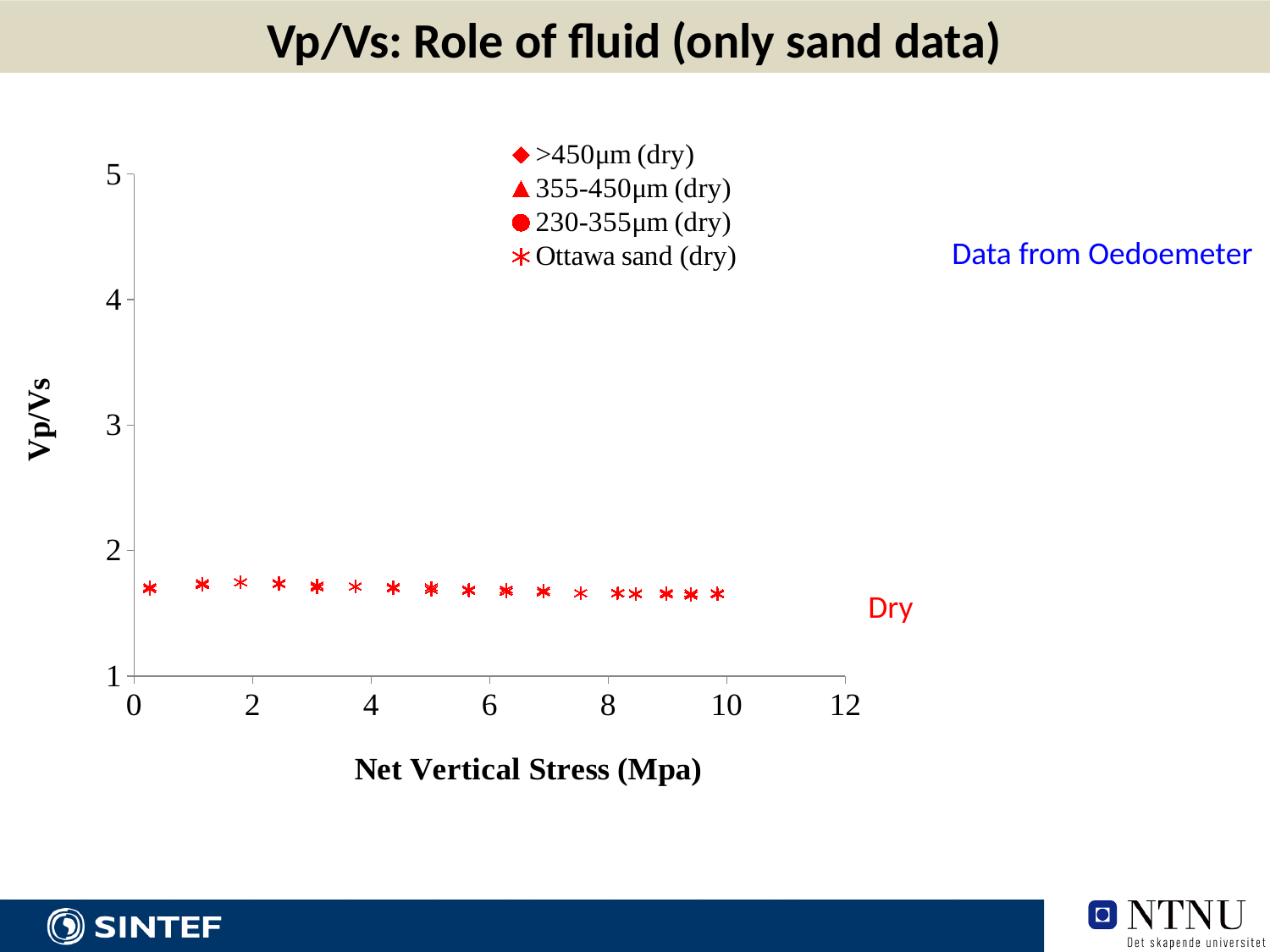
What kind of chart is shown on the slide? scatter chart How many series does the legend list? 4 Do the plotted Vp/Vs values rise sharply, fall sharply, or stay roughly flat as net vertical stress increases? stay roughly flat Are the plotted Vp/Vs values for Ottawa sand (dry) greater or less than 2? less What is the title of the y axis? Vp/Vs Is the Vp/Vs value at a net vertical stress of about 10 MPa greater or less than 3? less Are the plotted Vp/Vs values for Ottawa sand (dry) greater or less than 1? greater What is the first entry listed in the legend? >450μm (dry)